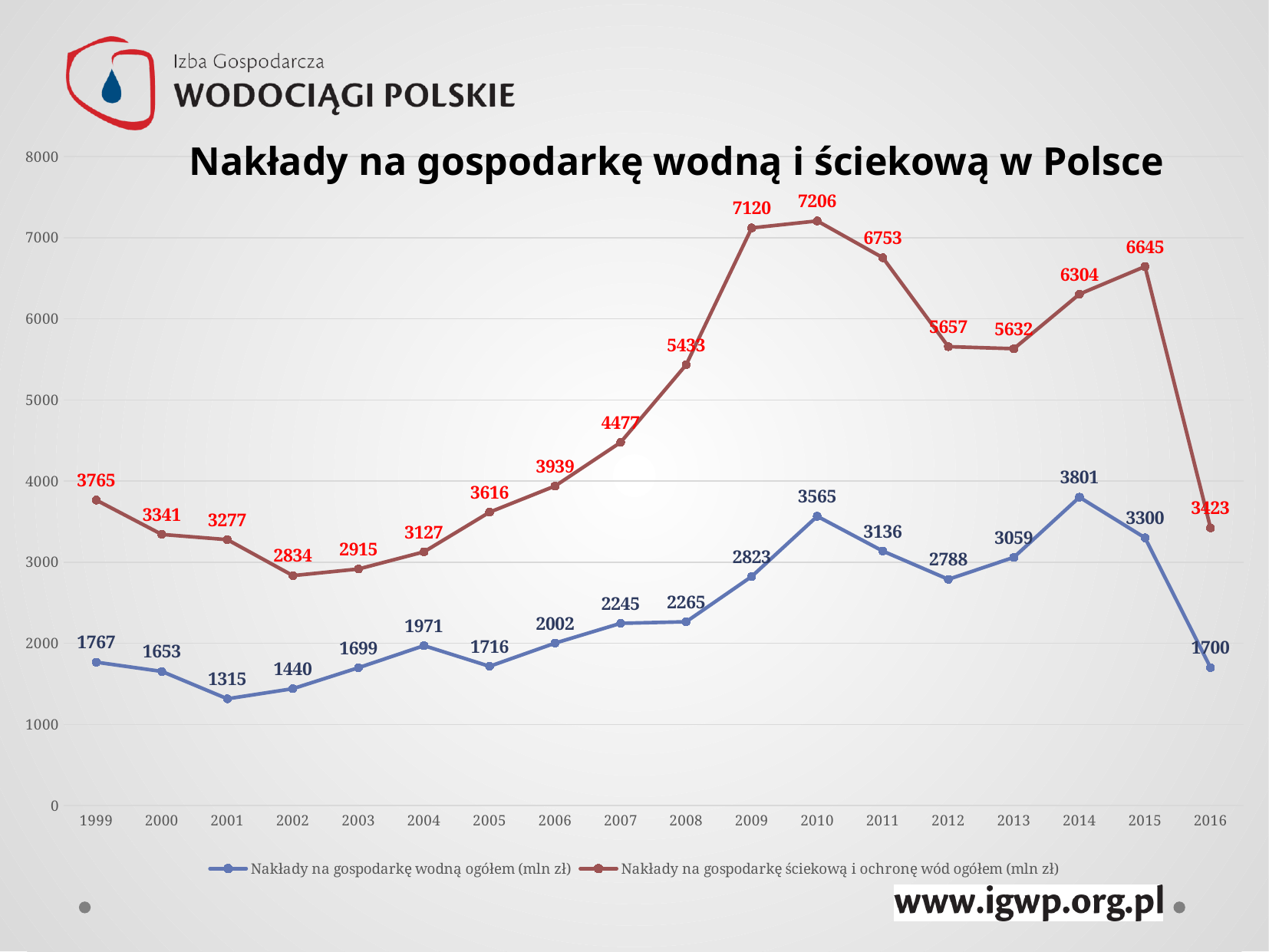
What is the value of 'Nakłady na gospodarkę ściekową i ochronę wód ogółem (mln zł)' in 2008? 5433 What is the title of the chart? Nakłady na gospodarkę wodną i ściekową w Polsce In which year is 'Nakłady na gospodarkę wodną ogółem (mln zł)' lowest? 2001 How many years are shown on the x axis? 18 What type of chart is shown on the slide? line chart Does 'Nakłady na gospodarkę ściekową i ochronę wód ogółem (mln zł)' rise or fall from 2005 to 2010? rise In which year is 'Nakłady na gospodarkę ściekową i ochronę wód ogółem (mln zł)' highest? 2010 Is the value of 'Nakłady na gospodarkę ściekową i ochronę wód ogółem (mln zł)' in 2009 greater or less than 7000? greater How many series does the legend list? 2 What is the difference between the two series in 2016? 1723 What is the value of 'Nakłady na gospodarkę wodną ogółem (mln zł)' in 2010? 3565 Which is larger: 'Nakłady na gospodarkę wodną ogółem (mln zł)' in 2014 or in 2015? 2014